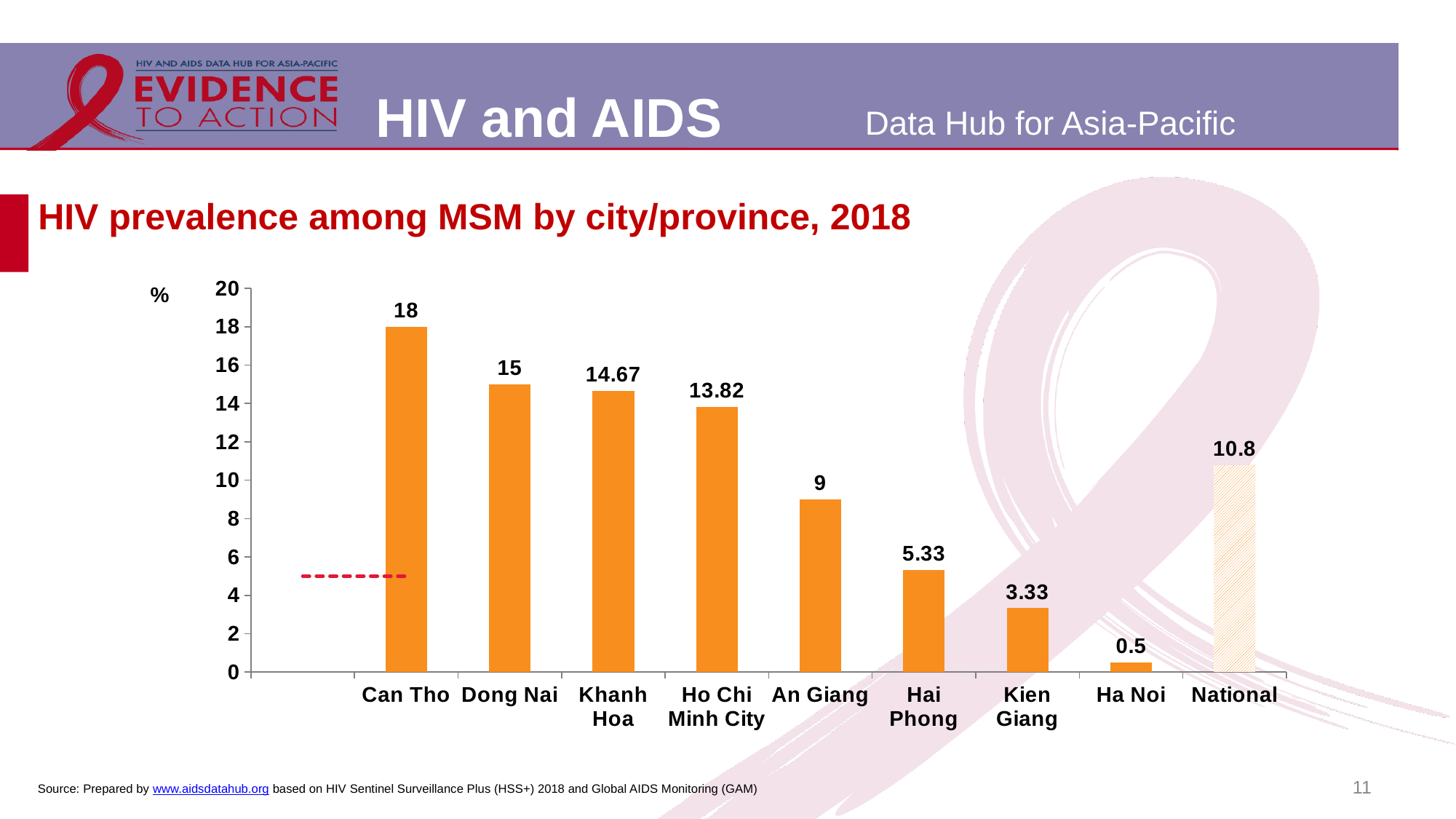
What is the title of the chart? HIV prevalence among MSM by city/province, 2018 What is the difference between the HIV prevalence in Dong Nai and Khanh Hoa? 0.33 How many city/province categories (including National) are shown on the chart? 9 What is the HIV prevalence among MSM in Ho Chi Minh City? 13.82 Which city/province has the lowest HIV prevalence among MSM? Ha Noi What is the difference between the HIV prevalence in Hai Phong and Kien Giang? 2 Which has a higher HIV prevalence among MSM, An Giang or Hai Phong? An Giang What is the National HIV prevalence among MSM shown on the chart? 10.8 Which city/province has the highest HIV prevalence among MSM? Can Tho What is the HIV prevalence among MSM in Can Tho? 18 What is the HIV prevalence among MSM in Ha Noi? 0.5 What kind of chart is shown on the slide? Bar chart